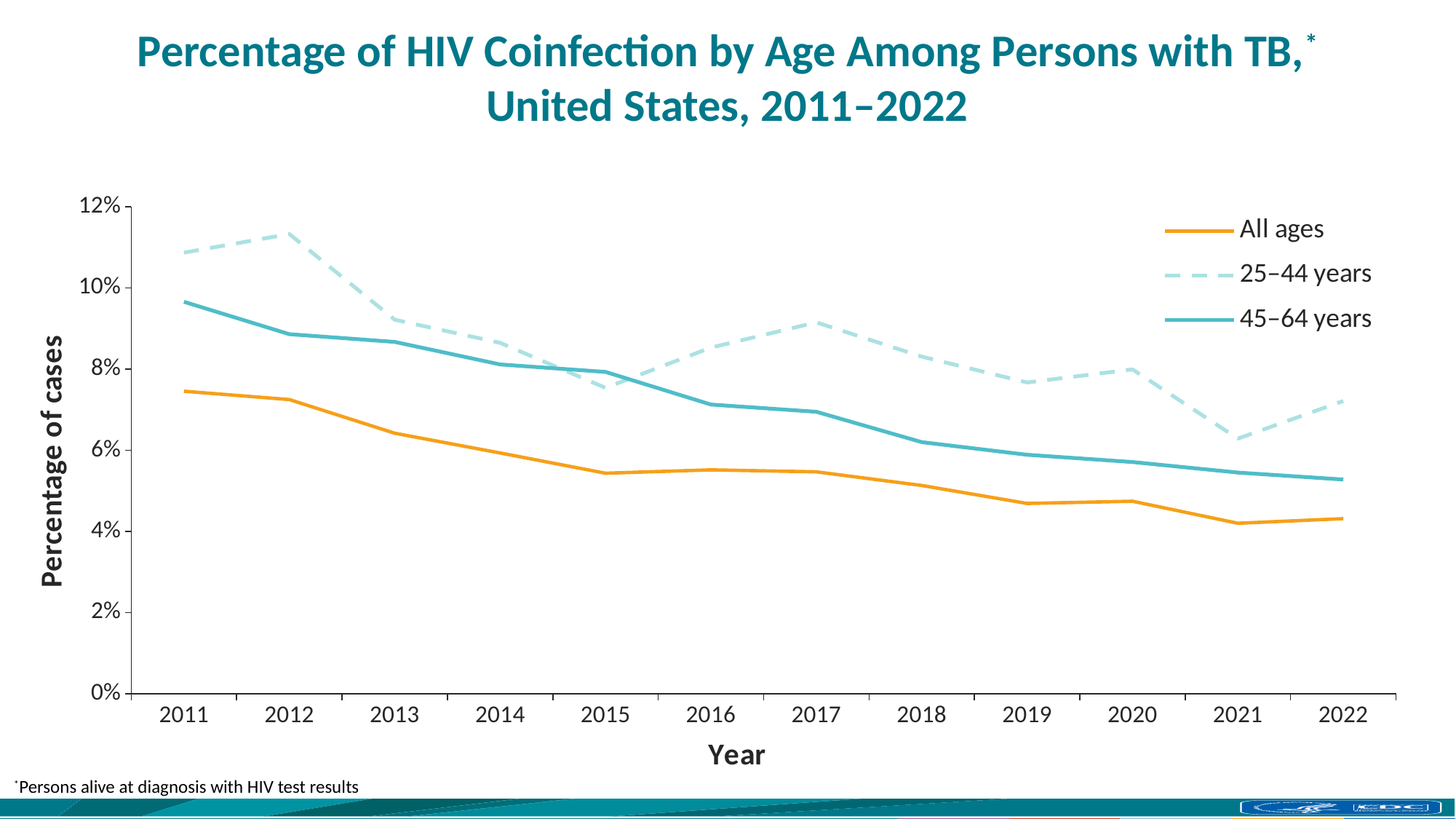
How many series does the legend list? 3 Does the 45–64 years line generally rise or fall from 2011 to 2022? Fall Is the 25–44 years value for 2012 greater or less than 10%? greater Does the All ages line generally rise or fall from 2011 to 2022? Fall Is the 45–64 years value for 2022 greater or less than 6%? less What kind of chart is shown on the slide? Line chart In which year is the 25–44 years value highest? 2012 How many years are plotted along the x axis? 12 In 2011, which is larger: the 25–44 years value or the 45–64 years value? 25–44 years Is the All ages value for 2011 greater or less than 6%? greater In which year is the 45–64 years value lowest? 2022 What is the label on the y axis? Percentage of cases